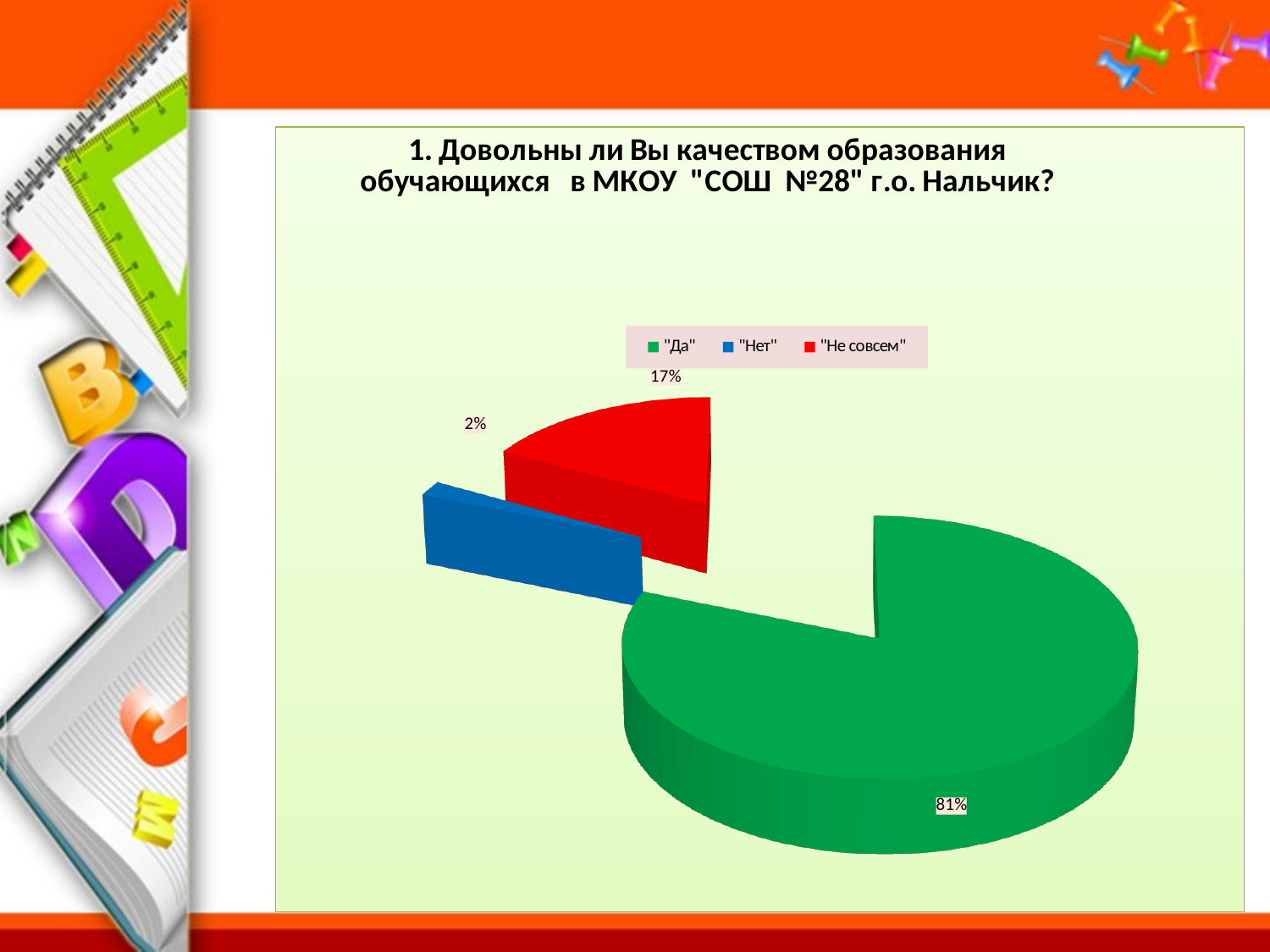
What is the difference in percentage points between "Да" and "Не совсем"? 64 What percentage of respondents answered "Не совсем"? 17% Which is larger, the share for "Нет" or the share for "Не совсем"? "Не совсем" What colour is the slice for "Нет"? Blue Which answer has the smallest share of the pie? "Нет" What is the difference in percentage points between "Не совсем" and "Нет"? 15 What percentage of respondents answered "Да"? 81% How many slices does the pie chart have? 3 How many entries does the legend list? 3 Which answer has the largest share of the pie? "Да" What kind of chart is shown on the slide? Pie chart What percentage of respondents answered "Нет"? 2%